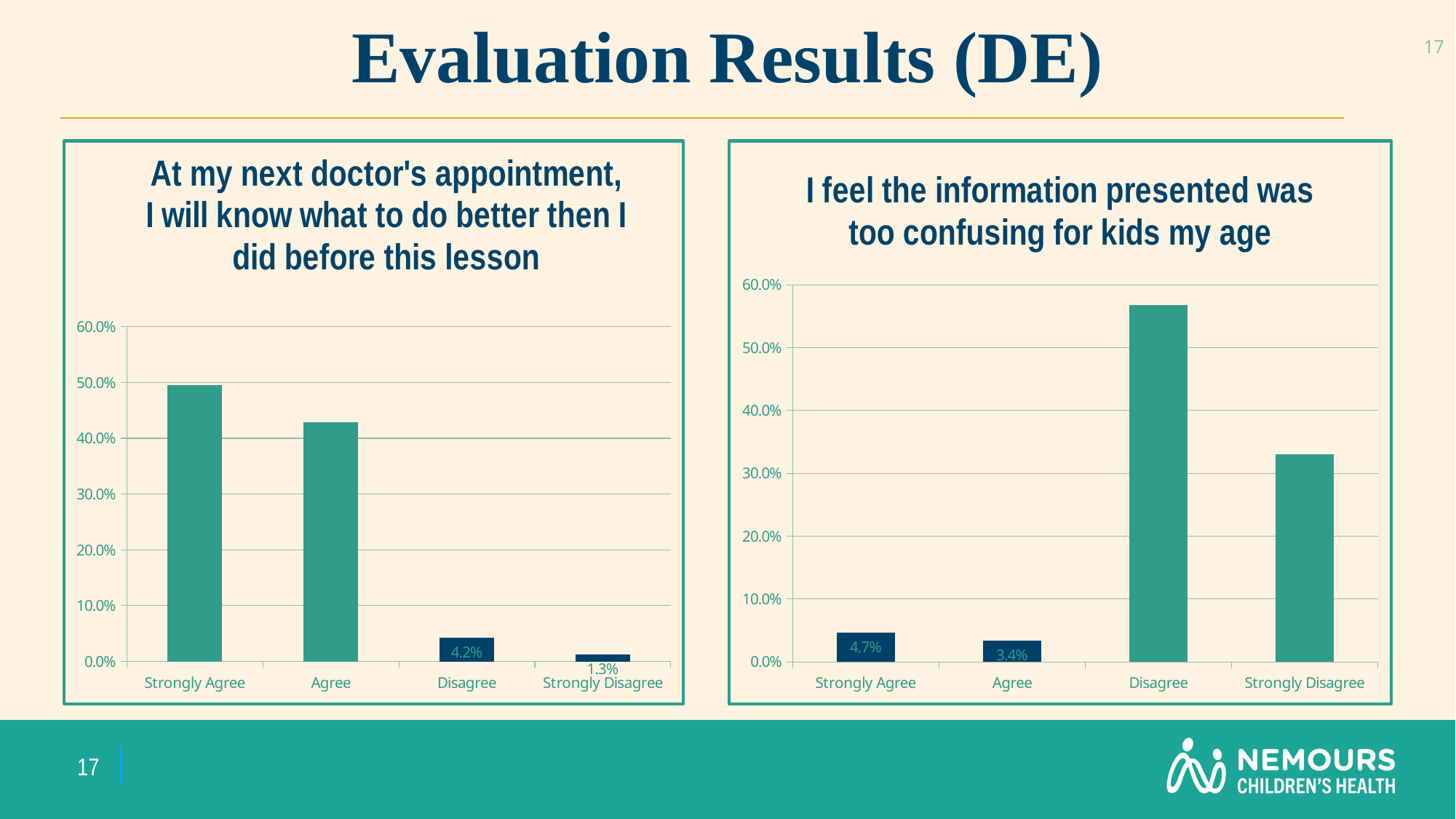
In the left chart ("At my next doctor's appointment..."), is the value for Agree greater or less than 40.0%? greater In the left chart ("At my next doctor's appointment..."), which category has the highest value? Strongly Agree In the right chart ("I feel the information presented was too confusing..."), what is the value for Agree? 3.4% In the right chart ("I feel the information presented was too confusing..."), is the value for Strongly Disagree greater or less than 30.0%? greater In the left chart ("At my next doctor's appointment..."), what is the value for Disagree? 4.2% In the right chart ("I feel the information presented was too confusing..."), which category has the highest value? Disagree What type of chart is the left chart ("At my next doctor's appointment...")? Bar chart In the right chart ("I feel the information presented was too confusing..."), what is the value for Strongly Agree? 4.7% In the left chart ("At my next doctor's appointment..."), what is the value for Strongly Disagree? 1.3% How many categories are shown on the x axis of the right chart ("I feel the information presented was too confusing...")? 4 In the right chart ("I feel the information presented was too confusing..."), which category has the lowest value? Agree In the left chart ("At my next doctor's appointment..."), what is the difference between the values for Disagree and Strongly Disagree? 2.9%